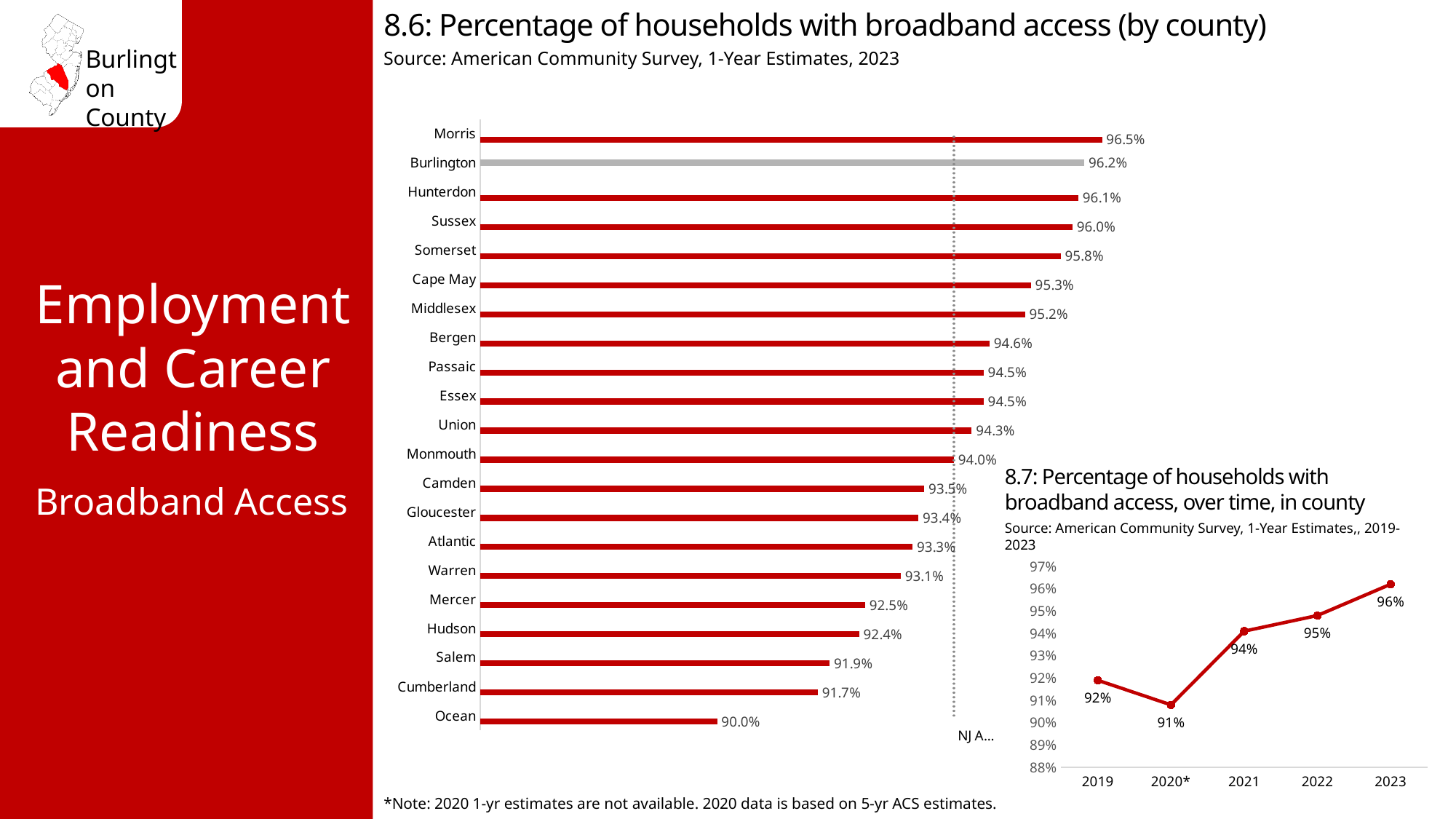
In chart 8.6, what is the value shown for Ocean County? 90.0% In chart 8.6, which county has a higher value, Camden or Mercer? Camden In chart 8.6, which county has the lowest percentage of households with broadband access? Ocean In chart 8.6, which county has the highest percentage of households with broadband access? Morris In chart 8.7, do the values generally rise or fall from 2020 to 2023? Rise In chart 8.7, what is the difference between the 2023 value and the 2019 value? 4% In chart 8.6, what is the difference between Morris County's value and Ocean County's value? 6.5% In chart 8.7, which year has the lowest percentage of households with broadband access? 2020* What kind of chart is chart 8.6? Bar chart In chart 8.7, what is the percentage of households with broadband access in 2021? 94% In chart 8.6, what is the percentage of households with broadband access in Burlington County? 96.2% In chart 8.6, how many counties are shown? 21